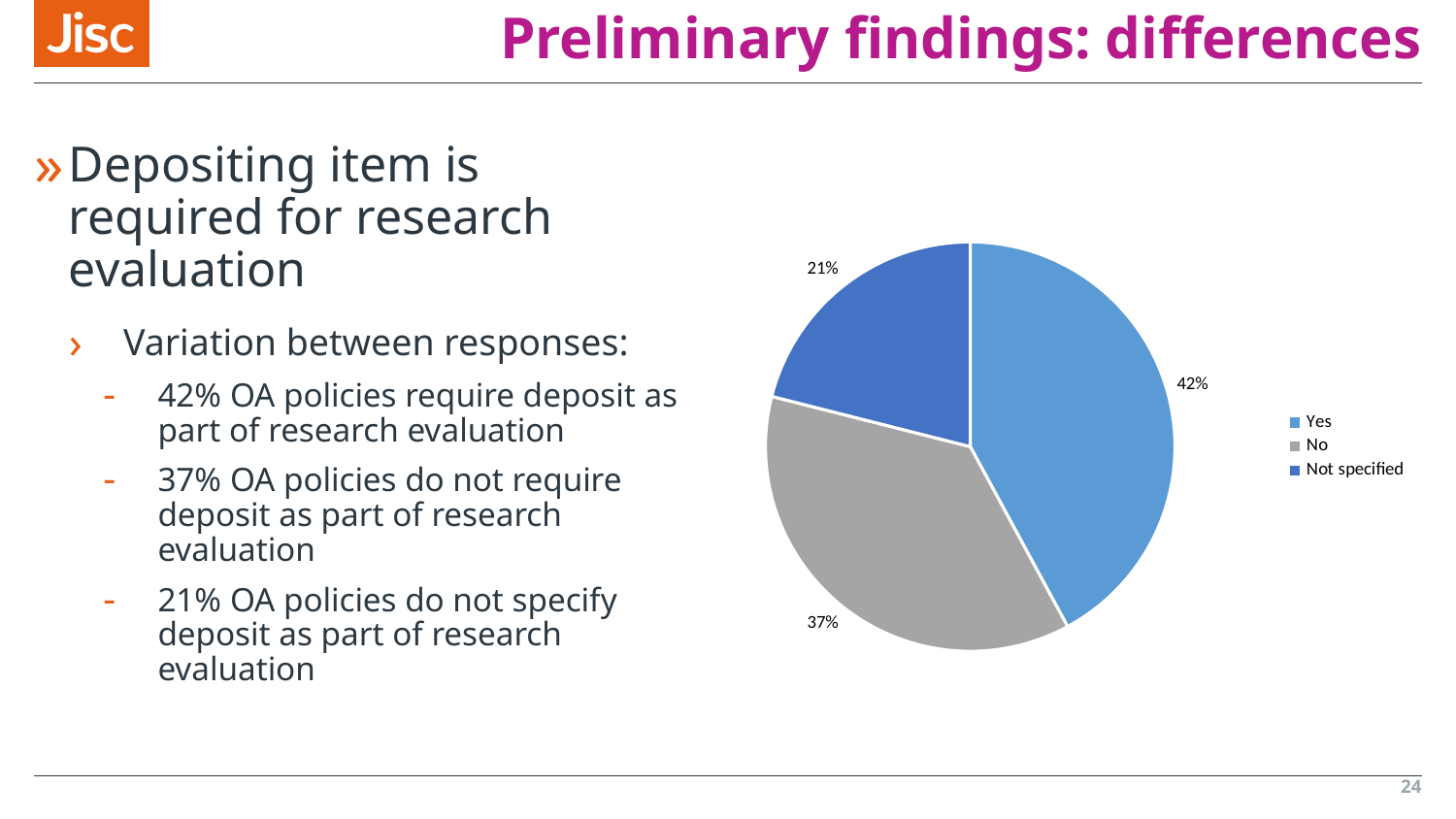
What percentage of the pie is labelled "Yes"? 42% What colour is the "No" slice in the pie chart? grey What percentage of the pie is labelled "No"? 37% How many entries does the legend list? 3 What percentage of the pie is labelled "Not specified"? 21% What is the difference in percentage points between the "Yes" and "No" slices? 5 How many categories does the pie chart show? 3 Which category has the smallest slice of the pie? Not specified Which category has the largest slice of the pie? Yes Which slice is larger, "No" or "Not specified"? No What kind of chart is shown on the slide? pie chart What is the difference in percentage points between the "No" and "Not specified" slices? 16